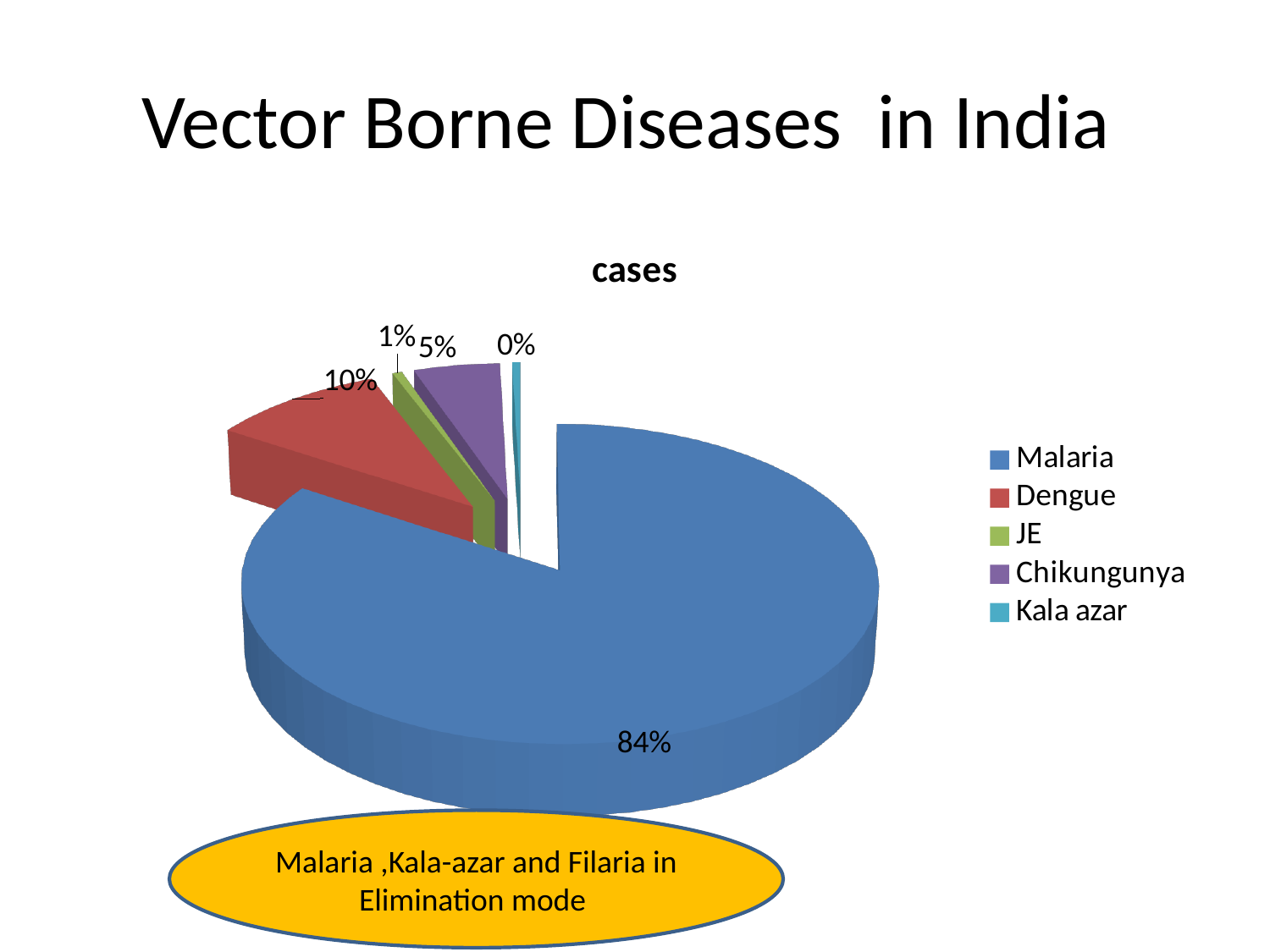
How many diseases are listed in the legend? 5 Which disease has the smallest share of cases? Kala azar What percentage of cases does Dengue account for? 10% What is the title of the chart? cases What percentage of cases does Chikungunya account for? 5% What percentage of cases does JE account for? 1% What type of chart is shown on the slide? pie chart What is the difference in percentage points between the Malaria share and the Dengue share? 74 What percentage of cases does Kala azar account for? 0% What percentage of cases does Malaria account for? 84% Which has a larger share of cases, Dengue or Chikungunya? Dengue Which disease has the largest share of cases? Malaria